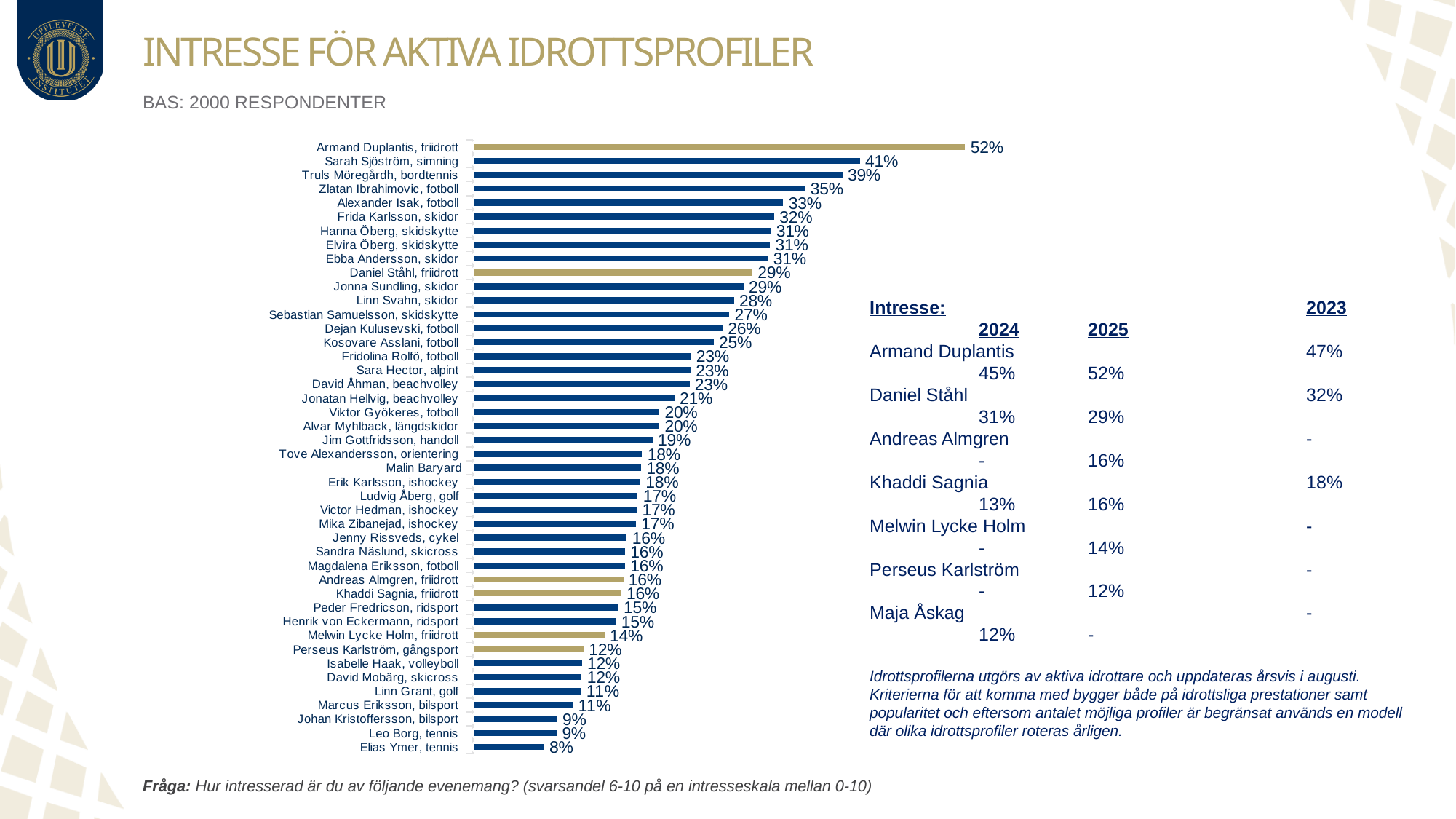
Which athlete has the highest value in the chart? Armand Duplantis, friidrott What is the value for Armand Duplantis, friidrott? 52% What is the value for Zlatan Ibrahimovic, fotboll? 35% How many athletes are shown in the bar chart? 44 Which athlete has the lowest value in the chart? Elias Ymer, tennis What is the value for Daniel Ståhl, friidrott? 29% Which has a larger value: Ludvig Åberg, golf or Linn Grant, golf? Ludvig Åberg, golf What is the difference between the values for Truls Möregårdh, bordtennis and Elias Ymer, tennis? 31% What is the value for Perseus Karlström, gångsport? 12% Which has a larger value: Frida Karlsson, skidor or Linn Svahn, skidor? Frida Karlsson, skidor What type of chart is shown on the slide? Bar chart What is the difference between the values for Armand Duplantis, friidrott and Sarah Sjöström, simning? 11%